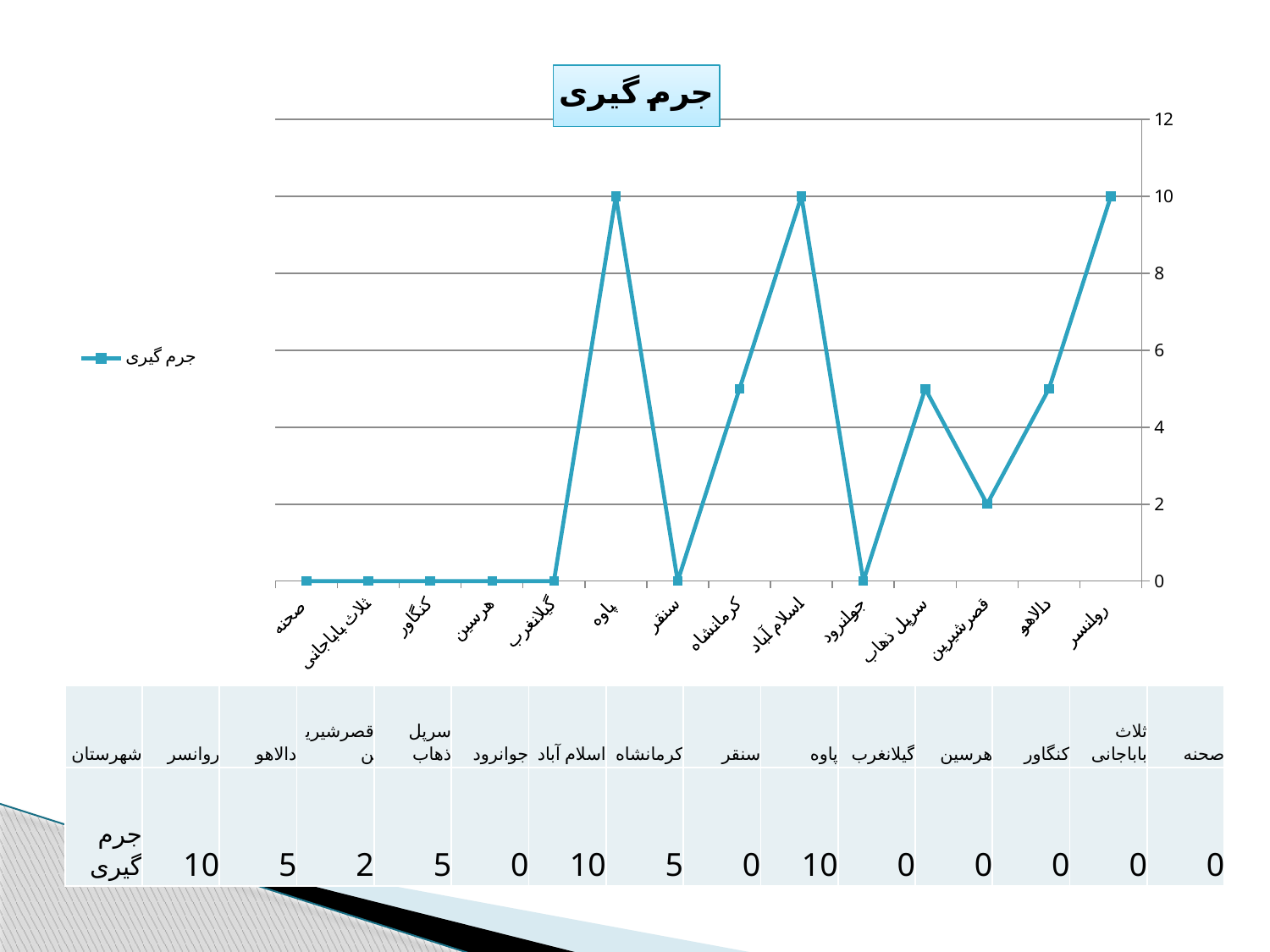
Which is larger in the جرم گیری chart, the value for سرپل ذهاب or the value for قصرشیرین? سرپل ذهاب How many categories are plotted along the x axis of the جرم گیری chart? 14 What is the value for کرمانشاه in the جرم گیری chart? 5 What is the difference between the values for روانسر and دالاهو in the جرم گیری chart? 5 What is the highest value shown on the y axis of the جرم گیری chart? 12 What is the value for پاوه in the جرم گیری chart? 10 What is the value for قصرشیرین in the جرم گیری chart? 2 Is the value for اسلام آباد in the جرم گیری chart greater or less than 8? greater What kind of chart is the جرم گیری chart? line chart How many series does the legend of the جرم گیری chart list? 1 What is the title of the chart on the slide? جرم گیری What is the value for سنقر in the جرم گیری chart? 0